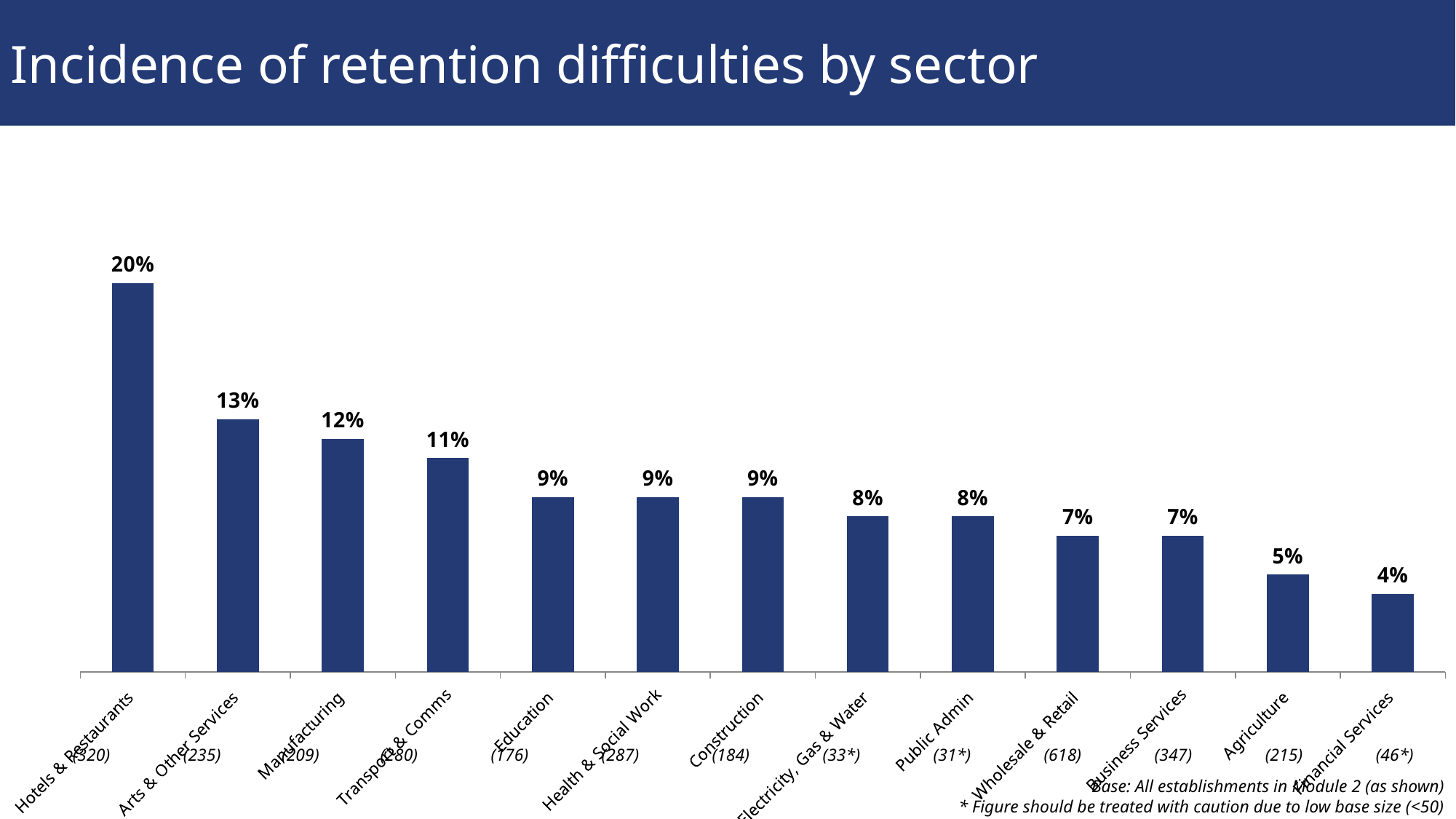
What is the difference between the values for Transport & Comms and Financial Services? 7% What is the value for Public Admin? 8% What kind of chart is shown on the slide? Bar chart How many sectors are shown in the chart? 13 What is the value for Manufacturing? 12% What is the difference between the values for Hotels & Restaurants and Arts & Other Services? 7% Which sector has the highest incidence of retention difficulties? Hotels & Restaurants What is the value for Agriculture? 5% Do the values rise or fall from left to right across the sectors? Fall Which is larger, the value for Construction or the value for Wholesale & Retail? Construction What is the value for Hotels & Restaurants? 20% Which sector has the lowest incidence of retention difficulties? Financial Services